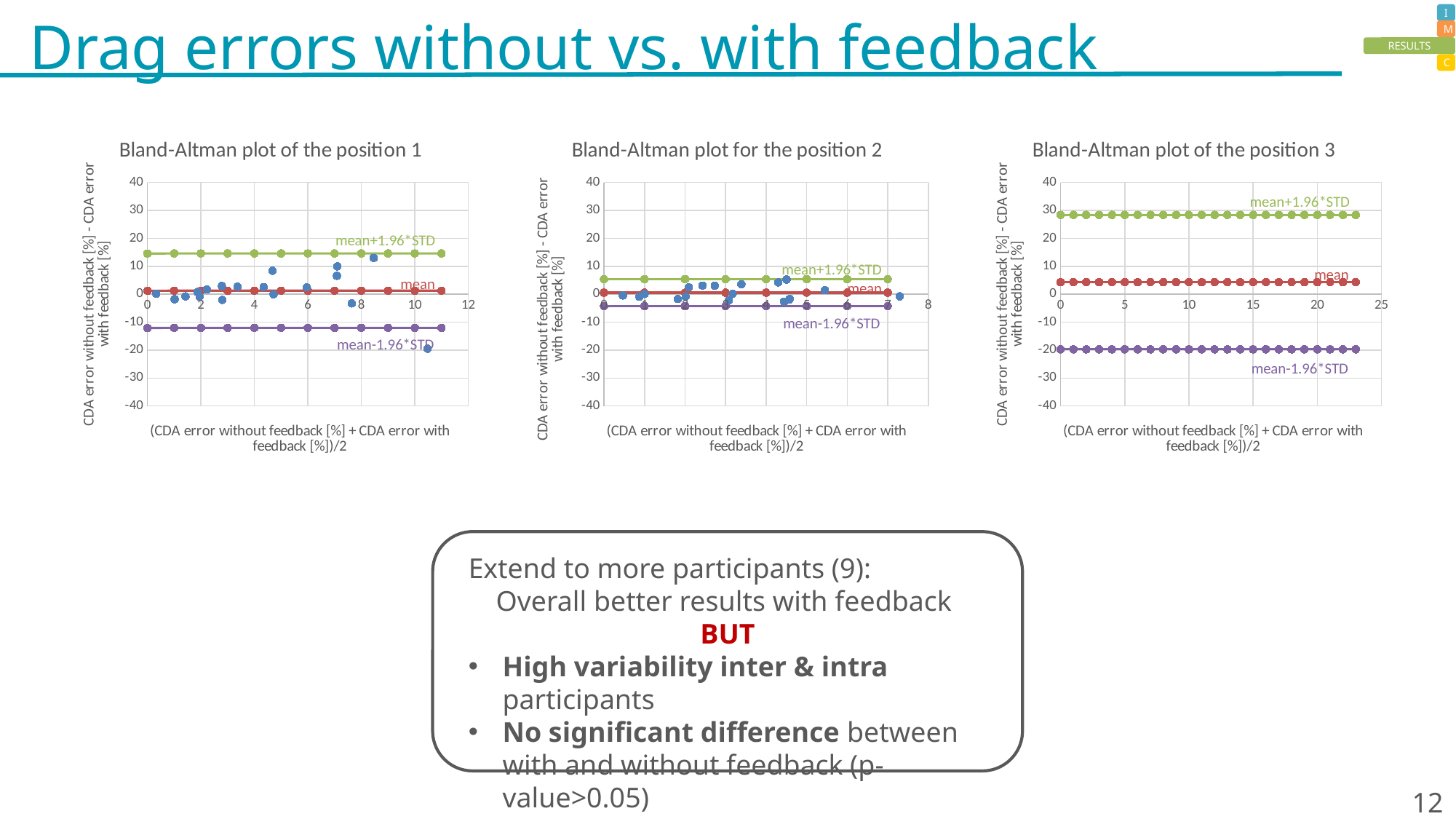
In the Bland-Altman plot of the position 1, is the mean-1.96*STD line greater or less than -10? less In the Bland-Altman plot of the position 3, is the mean+1.96*STD line greater or less than 20? greater How many Bland-Altman plots are shown on the slide? 3 In the Bland-Altman plot of the position 3, is the mean-1.96*STD line greater or less than -10? less What is the maximum value shown on the x axis of the Bland-Altman plot of the position 3? 25 What kind of chart is the Bland-Altman plot of the position 1? scatter chart What is the maximum value shown on the y axis of the Bland-Altman plot for the position 2? 40 Which of the three Bland-Altman plots has the highest mean+1.96*STD line? Bland-Altman plot of the position 3 Is the mean+1.96*STD line higher in the Bland-Altman plot of the position 1 or in the Bland-Altman plot for the position 2? Bland-Altman plot of the position 1